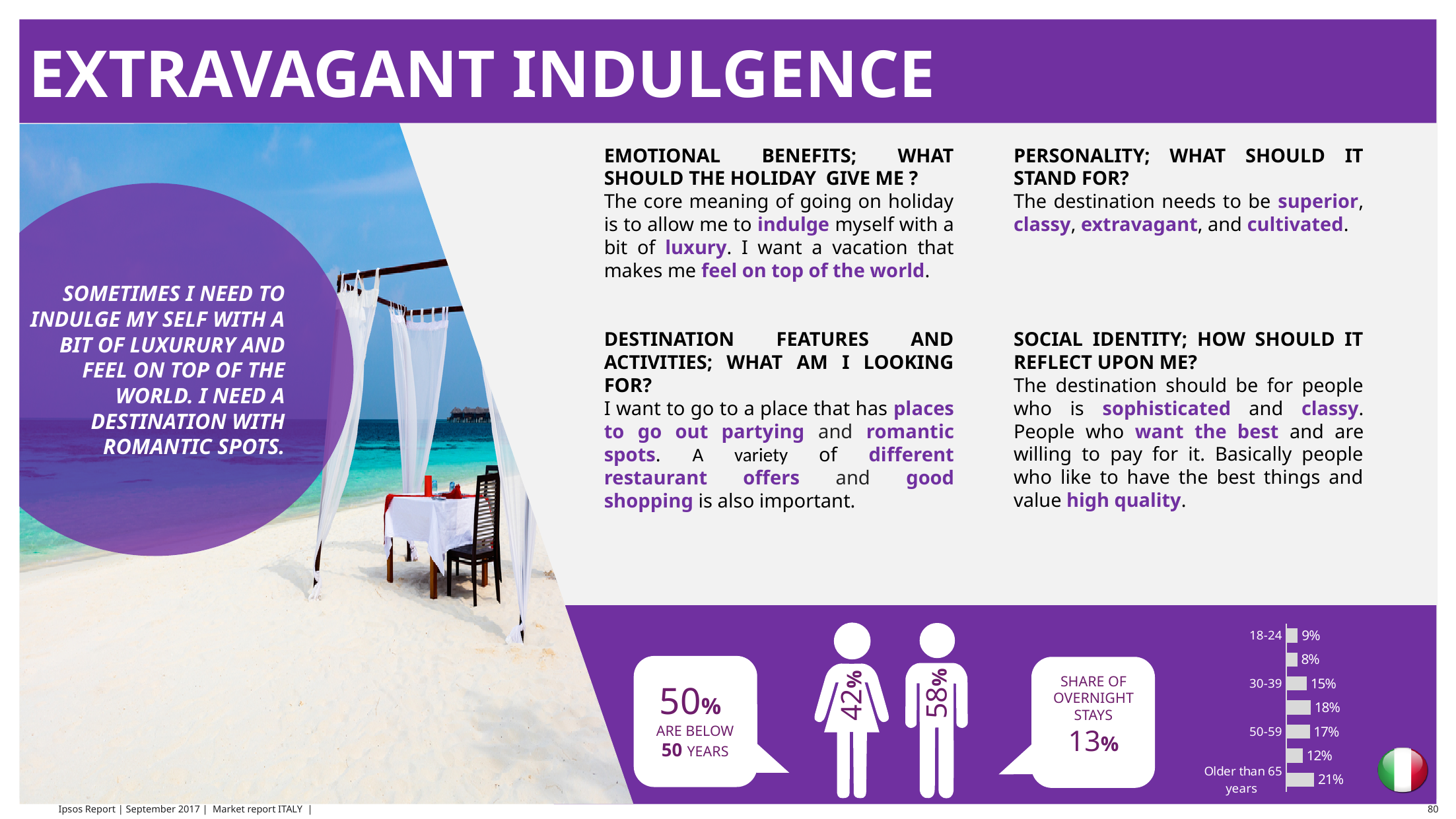
In the age chart, what is the value for the 50-59 age group? 17% In the age chart, what is the value for the 18-24 age group? 9% In the age chart, how many bars are plotted? 7 In the age chart, what is the value for the 30-39 age group? 15% What is the smallest value shown in the age chart? 8% In the age chart, what is the difference between the 50-59 value and the 30-39 value? 2 percentage points In the age chart, which age group has the highest value? Older than 65 years In the age chart, what is the difference between the 'Older than 65 years' value and the 18-24 value? 12 percentage points What kind of chart is shown at the bottom right of the slide? bar chart In the age chart, which is larger: the value for 30-39 or the value for 50-59? 50-59 What share of overnight stays is shown in the speech bubble next to the age chart? 13% In the age chart, what is the value for the 'Older than 65 years' group? 21%